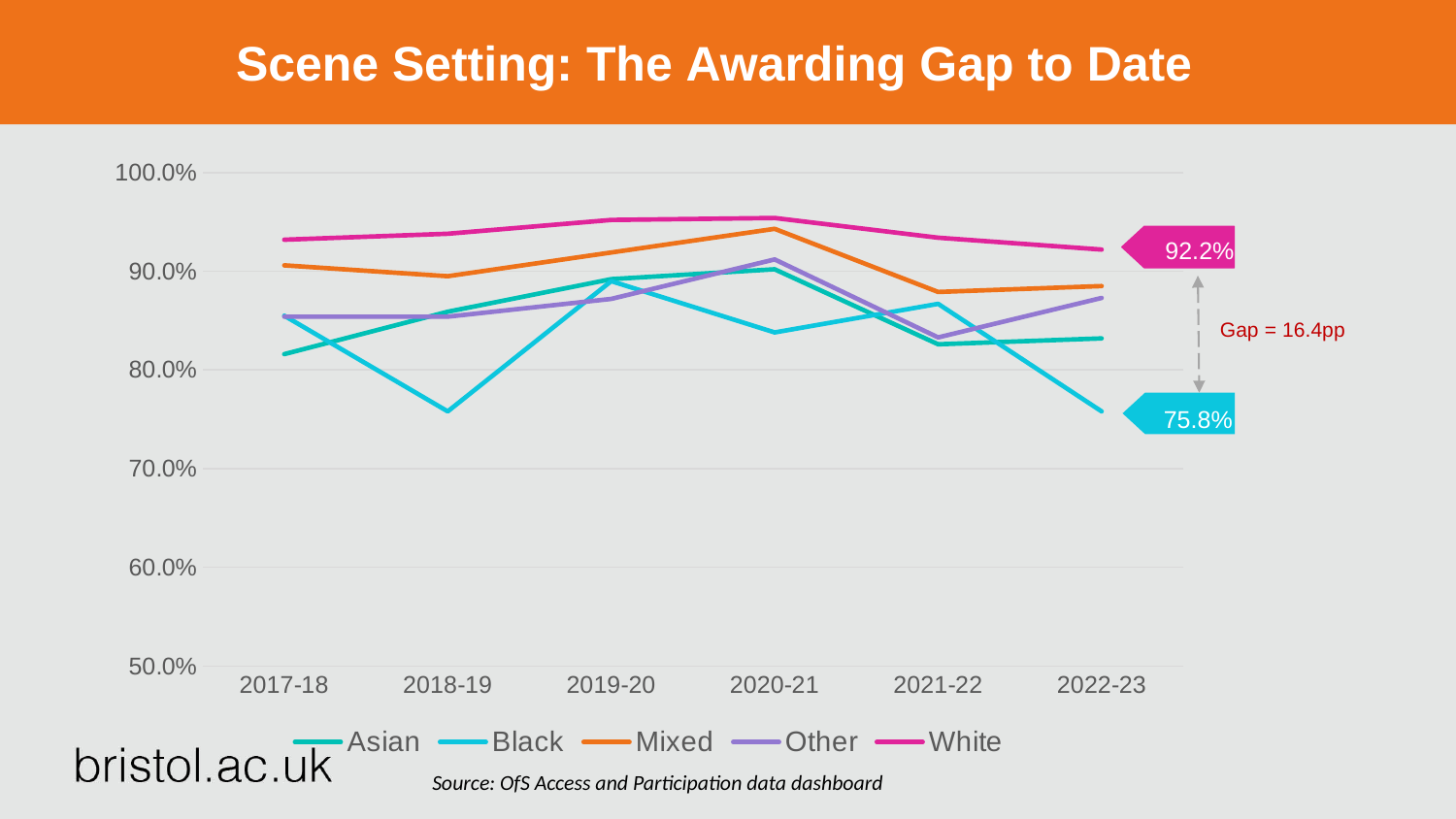
What is the gap between the White and Black values in 2022-23? 16.4pp What kind of chart is shown on the slide? line chart Which group has the lowest value in 2022-23? Black Is the value for White in 2017-18 greater or less than 90.0%? greater Which group has the highest value in 2022-23? White Is the value for Black in 2018-19 greater or less than 80.0%? less What is the value for White in 2022-23? 92.2% What is the value for Black in 2022-23? 75.8% In 2022-23, which is higher: Mixed or Asian? Mixed Does the White line rise or fall from 2020-21 to 2022-23? fall How many academic years are shown along the x axis? 6 How many series does the legend list? 5